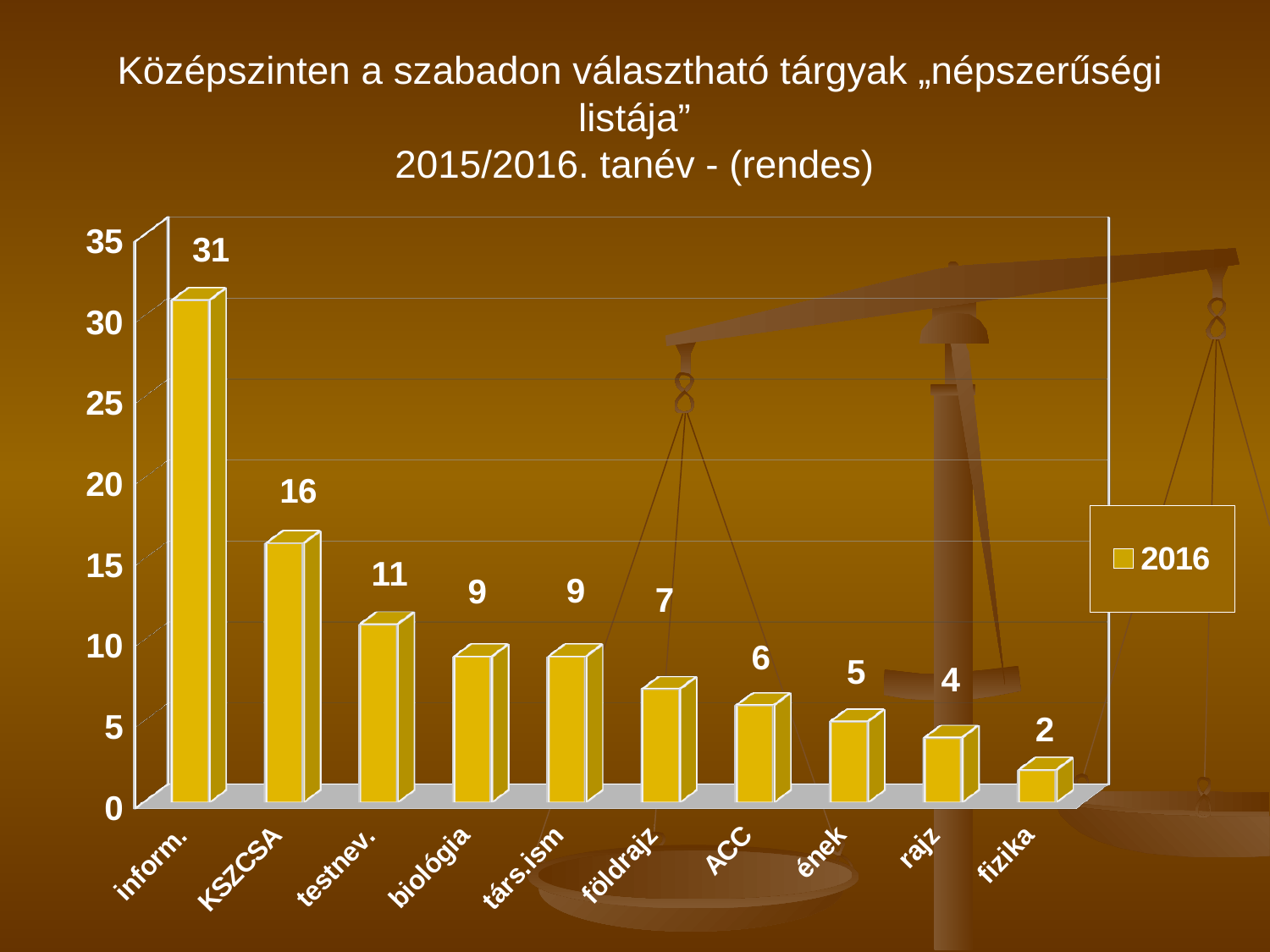
Which category has the lowest value? fizika Do the values rise or fall from left to right along the x axis? fall Which is larger, the value for testnev. or the value for ACC? testnev. What is the difference between the values for inform. and KSZCSA? 15 How many categories are shown on the x axis? 10 What is the value for földrajz? 7 What is the value for inform.? 31 What is the value for KSZCSA? 16 What kind of chart is shown on the slide? bar chart Which category has the highest value? inform. How many series does the legend list? 1 Is the value for ének greater or less than 10? less